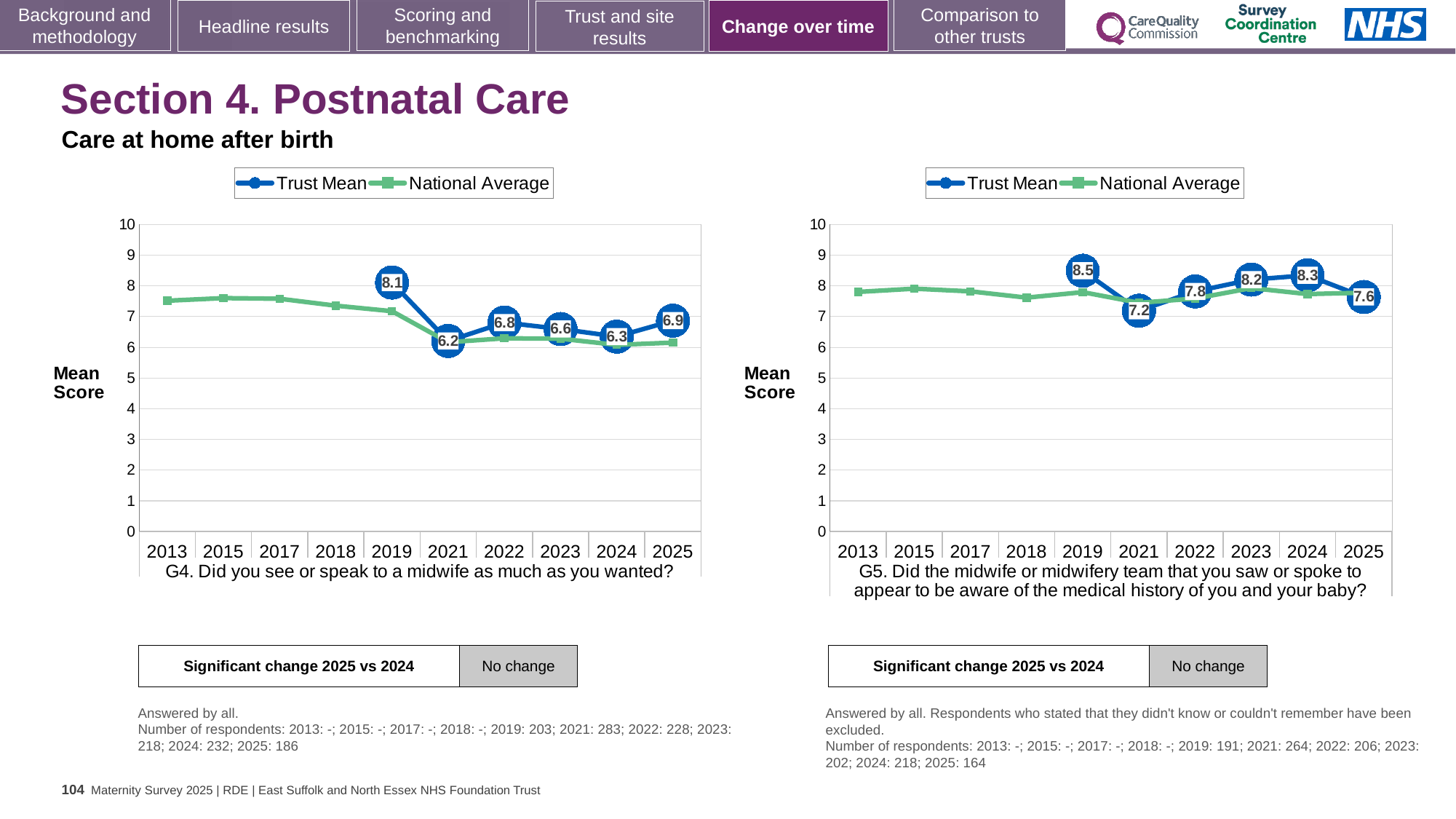
In the G5 chart (right), which is larger: the Trust Mean for 2022 or for 2023? 2023 In the G4 chart (left), which year has the highest Trust Mean? 2019 In the G4 chart (left), what is the difference between the Trust Mean in 2019 and in 2021? 1.9 How many years are shown on the x axis of the G5 chart (right)? 10 In the G5 chart (right), what is the difference between the Trust Mean in 2024 and in 2025? 0.7 In the G4 chart (left), what is the Trust Mean for 2025? 6.9 In the G5 chart (right), which year has the lowest Trust Mean? 2021 How many series does the legend of the G4 chart (left) list? 2 What kind of chart is the G4 chart (left)? Line chart In the G4 chart (left), what is the Trust Mean for 2019? 8.1 In the G5 chart (right), what is the Trust Mean for 2024? 8.3 In the G4 chart (left), is the National Average for 2013 greater or less than 7? greater